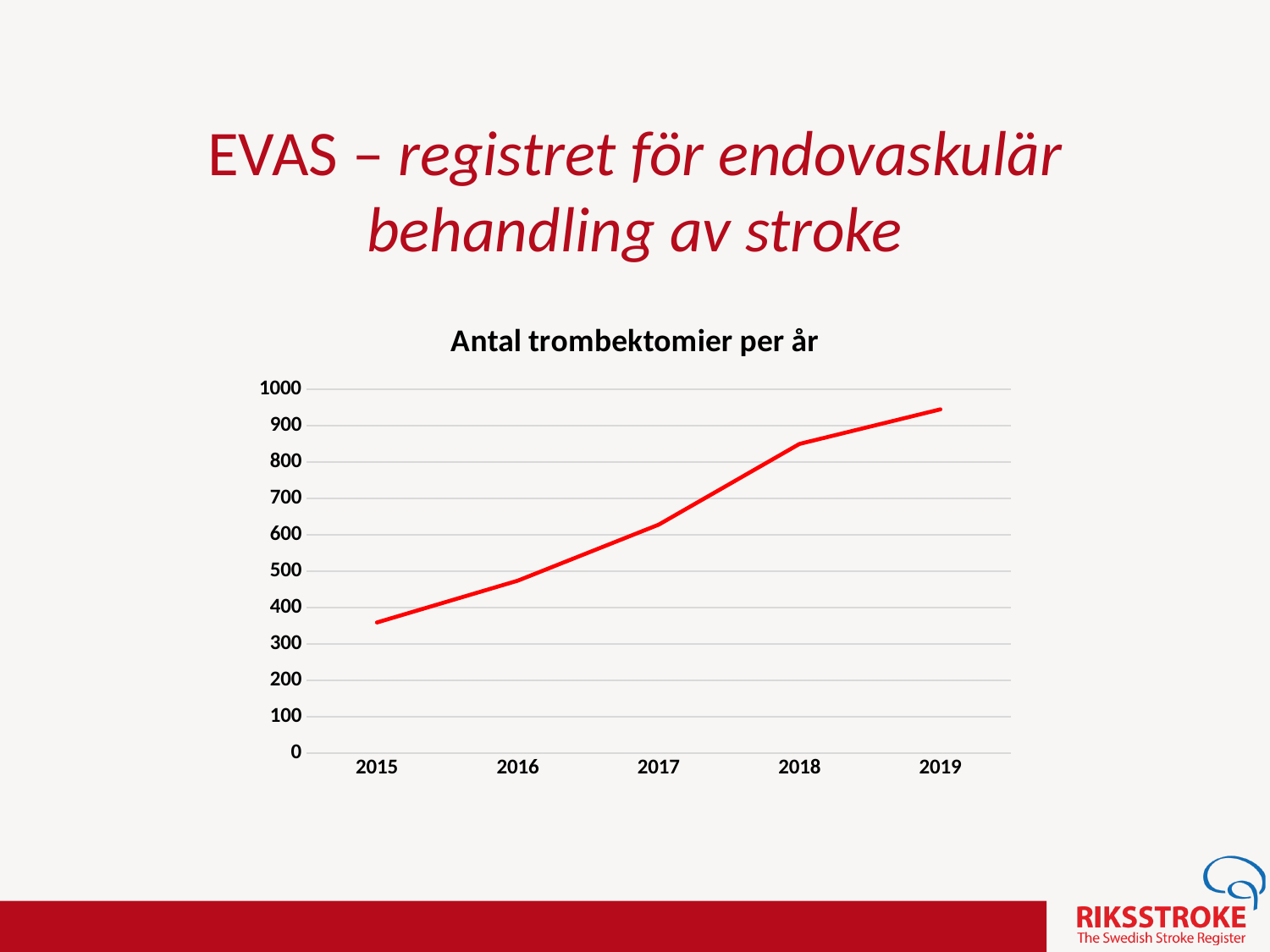
Is the value for 2017 greater or less than 600? greater What colour is the line in the chart? red Is the value for 2015 greater or less than 400? less Which year has the highest value in the chart? 2019 What is the title of the chart? Antal trombektomier per år How many years are plotted on the x axis of the chart? 5 Which year has the larger value, 2016 or 2018? 2018 What kind of chart is shown on the slide? line chart Do the values rise or fall from 2015 to 2019? rise Is the value for 2019 greater or less than 1000? less Which year has the lowest value in the chart? 2015